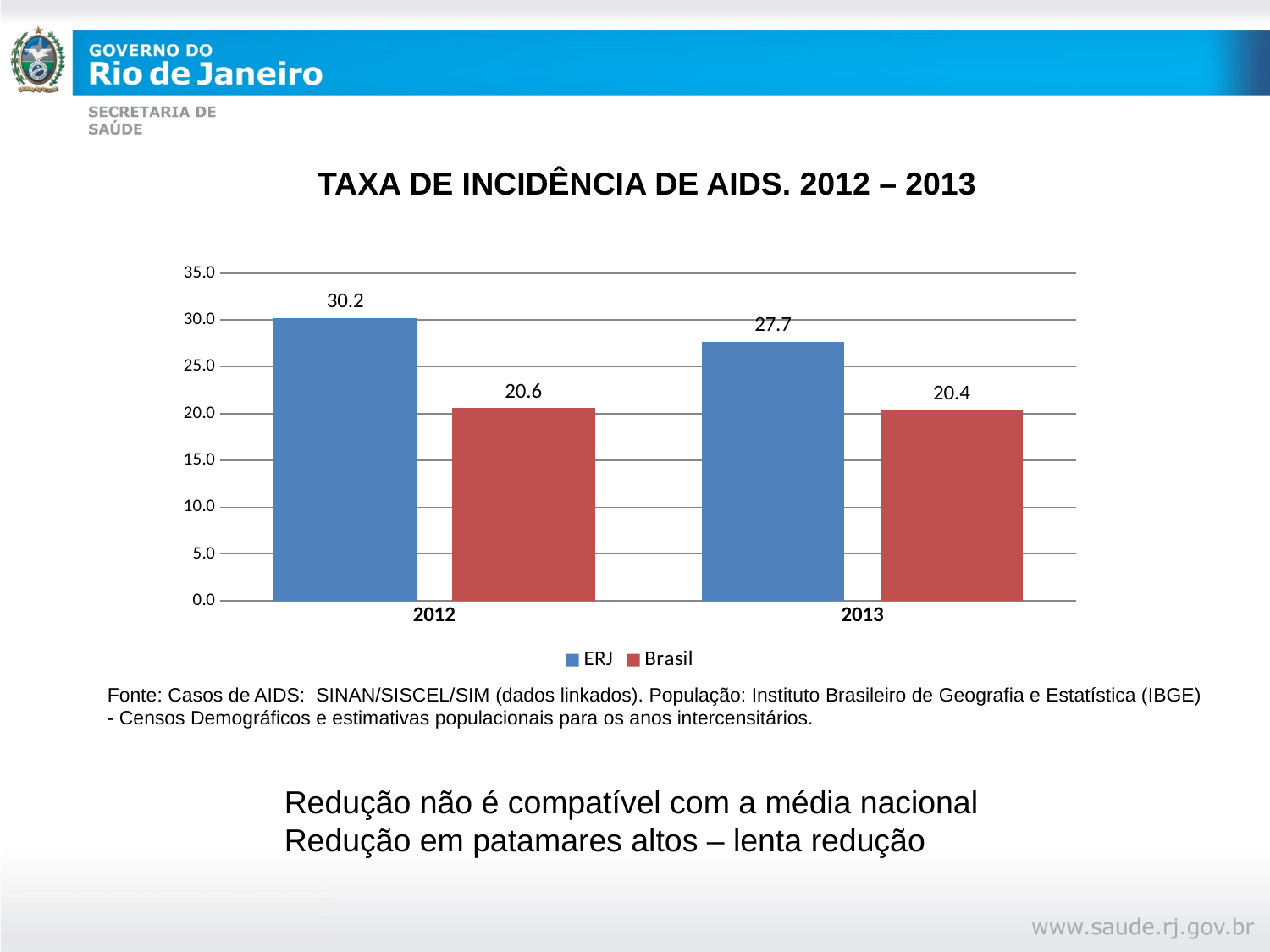
Which series has the highest value in 2012? ERJ What is the value for ERJ in 2012? 30.2 What kind of chart is shown on the slide? Bar chart What is the difference between the ERJ values in 2012 and 2013? 2.5 Which bar has the lowest value on the chart? Brasil in 2013 Do the ERJ values rise or fall from 2012 to 2013? Fall Is the value for ERJ in 2013 greater or less than 25.0? greater What is the value for ERJ in 2013? 27.7 Which is larger, the Brasil value in 2012 or the Brasil value in 2013? Brasil in 2012 What is the difference between the ERJ and Brasil values in 2012? 9.6 How many series does the legend list? 2 What is the value for Brasil in 2013? 20.4